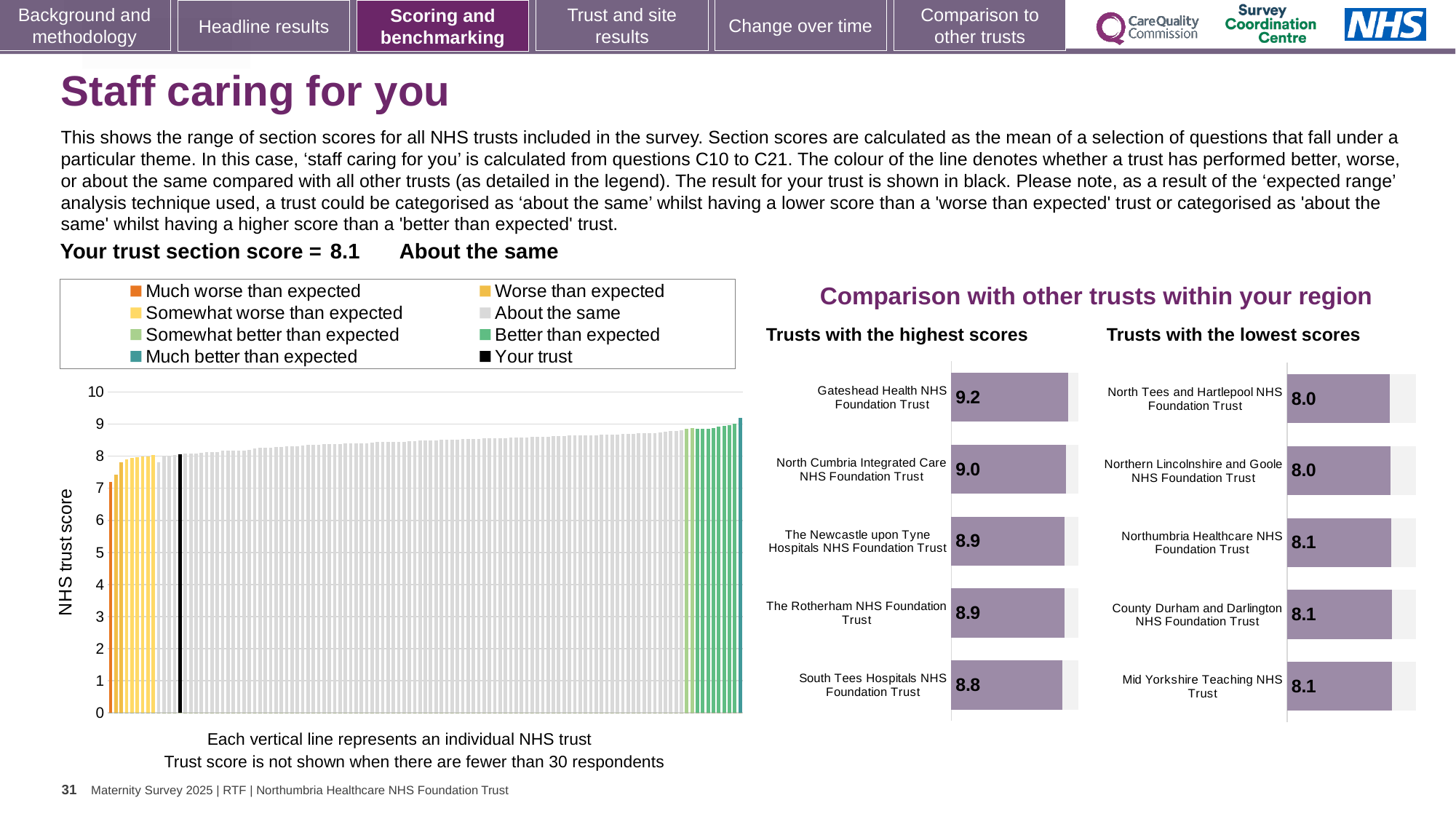
In the 'Trusts with the lowest scores' chart, what is the score for North Tees and Hartlepool NHS Foundation Trust? 8.0 In the 'Trusts with the highest scores' chart, what is the score for South Tees Hospitals NHS Foundation Trust? 8.8 In the NHS trust score chart on the left, do the bar heights rise or fall from left to right? Rise In the 'Trusts with the highest scores' chart, what is the score for Gateshead Health NHS Foundation Trust? 9.2 In the 'Trusts with the highest scores' chart, what is the difference between the scores of Gateshead Health NHS Foundation Trust and South Tees Hospitals NHS Foundation Trust? 0.4 In the 'Trusts with the highest scores' chart, which trust has the highest score? Gateshead Health NHS Foundation Trust What kind of chart is the NHS trust score chart on the left? Bar chart How many trusts are shown in the 'Trusts with the lowest scores' chart? 5 In the 'Trusts with the lowest scores' chart, what is the score for Northumbria Healthcare NHS Foundation Trust? 8.1 How many entries does the legend of the NHS trust score chart list? 8 In the NHS trust score chart on the left, is the value of the black 'Your trust' bar greater or less than 5? greater Comparing the two regional charts, which has the larger score: Gateshead Health NHS Foundation Trust in the highest scores chart or Mid Yorkshire Teaching NHS Trust in the lowest scores chart? Gateshead Health NHS Foundation Trust